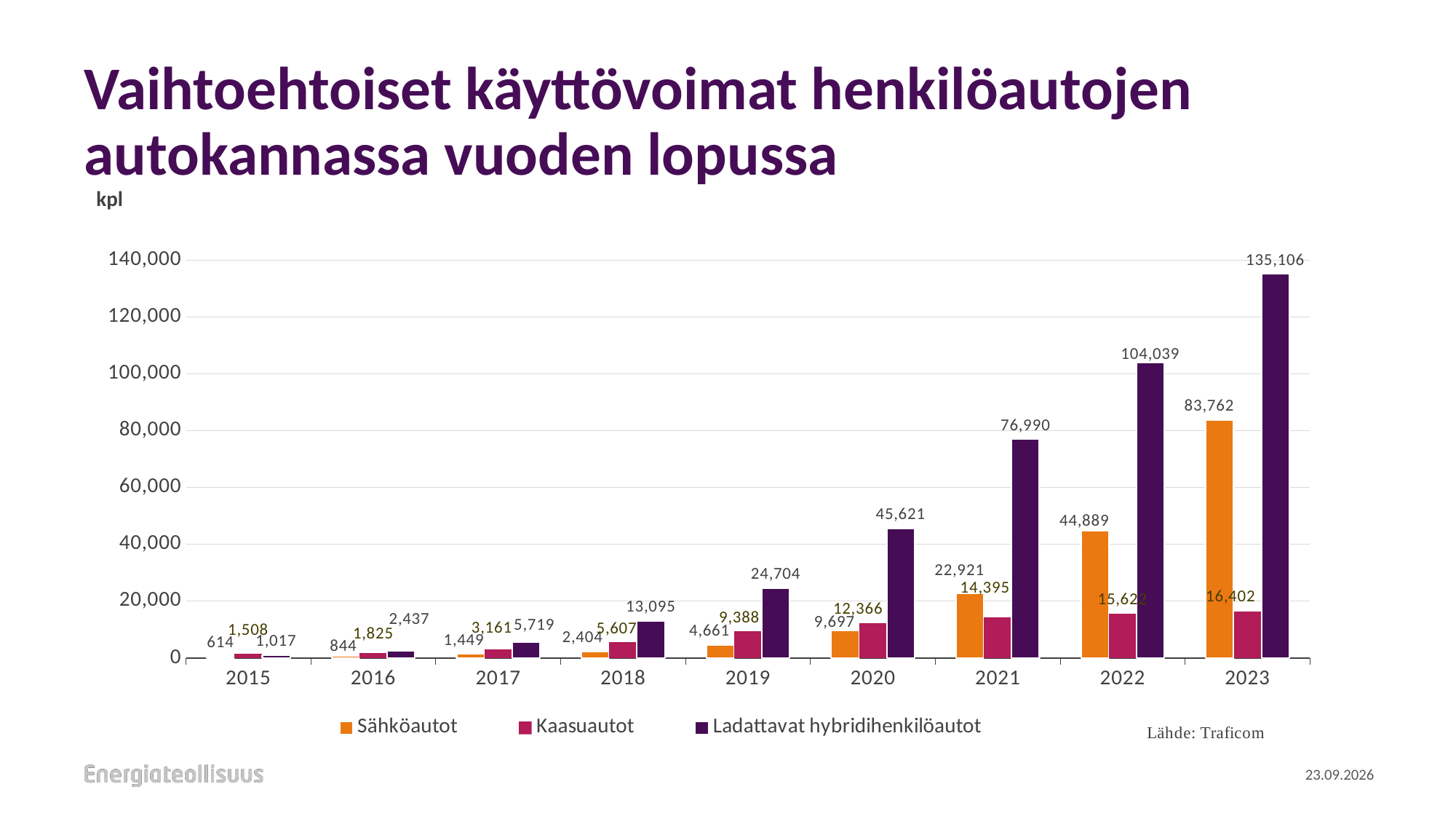
What is the value for Sähköautot in 2022? 44,889 What is the difference between Ladattavat hybridihenkilöautot and Sähköautot in 2023? 51,344 What is the value for Ladattavat hybridihenkilöautot in 2023? 135,106 What is the value for Kaasuautot in 2019? 9,388 In which year is the value for Sähköautot lowest? 2015 What kind of chart is shown on the slide? Bar chart How many years are shown on the x axis? 9 Do the values for Ladattavat hybridihenkilöautot rise or fall from 2015 to 2023? Rise How many series does the legend list? 3 In which year is the value for Sähköautot highest? 2023 By how much did the value for Kaasuautot increase from 2021 to 2022? 1,227 In 2021, which is larger: Sähköautot or Kaasuautot? Sähköautot